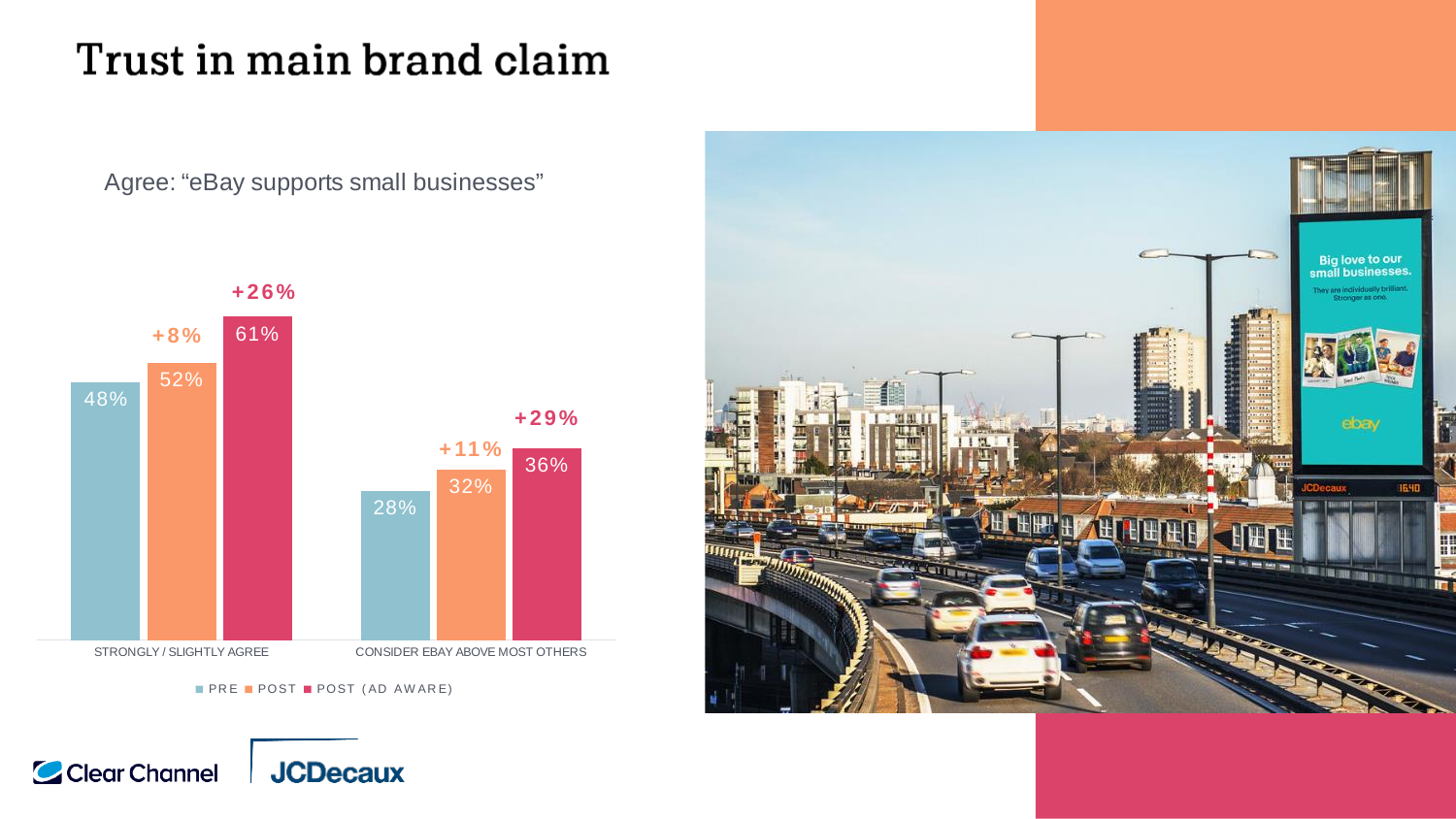
What kind of chart is shown on the slide? Bar chart What is the PRE value for CONSIDER EBAY ABOVE MOST OTHERS? 28% What is the POST (AD AWARE) value for CONSIDER EBAY ABOVE MOST OTHERS? 36% Which is larger: the POST value for STRONGLY / SLIGHTLY AGREE or the POST (AD AWARE) value for CONSIDER EBAY ABOVE MOST OTHERS? POST value for STRONGLY / SLIGHTLY AGREE Which series has the lowest value for CONSIDER EBAY ABOVE MOST OTHERS? PRE How many series does the legend list? 3 What is the PRE value for STRONGLY / SLIGHTLY AGREE? 48% Which series has the highest value for STRONGLY / SLIGHTLY AGREE? POST (AD AWARE) What uplift label is shown above the POST (AD AWARE) bar for CONSIDER EBAY ABOVE MOST OTHERS? +29% What is the POST value for STRONGLY / SLIGHTLY AGREE? 52% How many categories are shown on the x axis? 2 What is the difference between the POST (AD AWARE) and PRE values for STRONGLY / SLIGHTLY AGREE? 13%